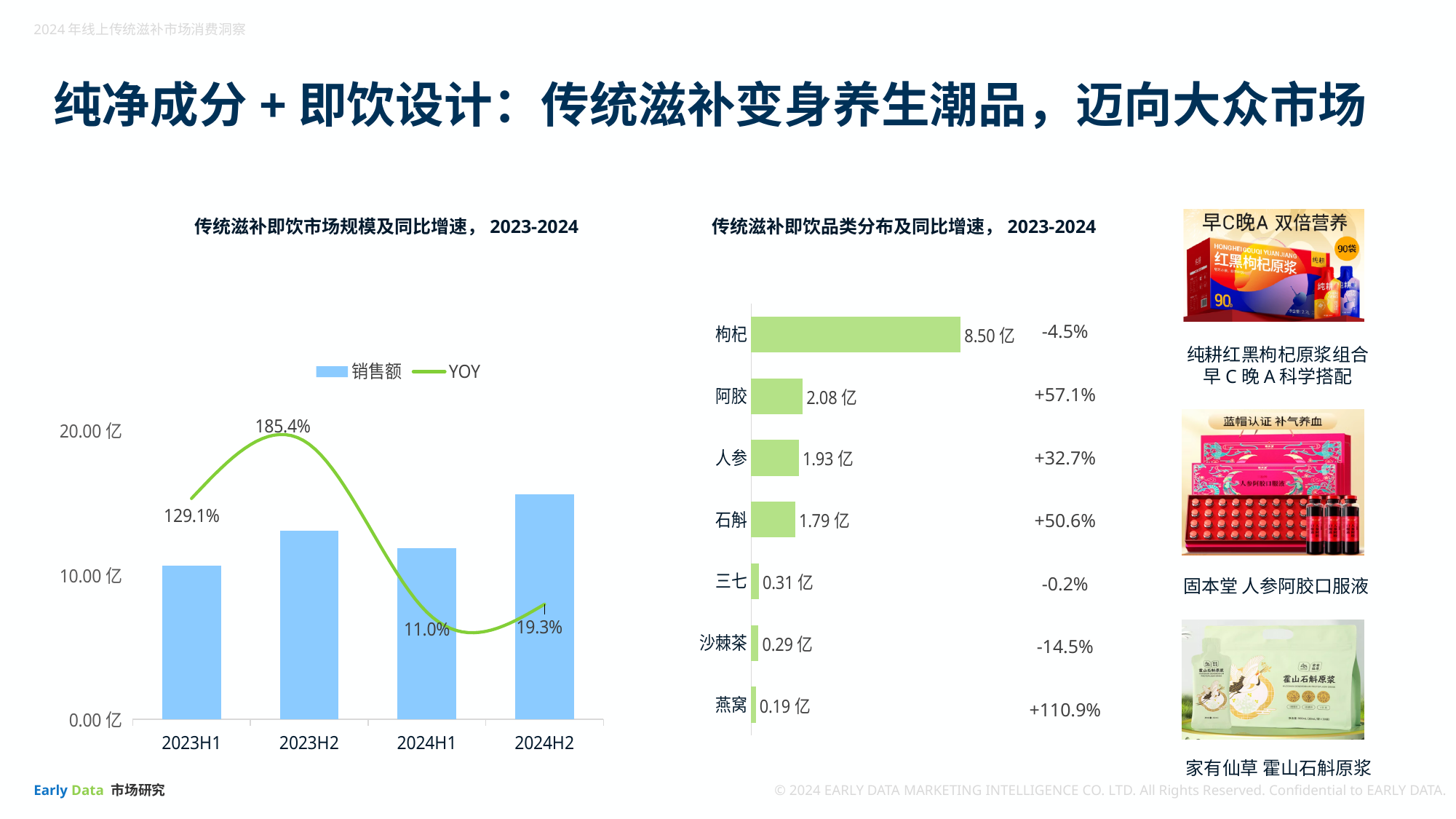
In the chart titled 传统滋补即饮品类分布及同比增速，2023-2024, what is the difference between the values for 枸杞 and 阿胶? 6.42 亿 In the chart titled 传统滋补即饮市场规模及同比增速，2023-2024, is the 销售额 bar for 2024H2 greater or less than 20.00 亿? less In the chart titled 传统滋补即饮市场规模及同比增速，2023-2024, is the 销售额 bar for 2023H2 greater or less than 10.00 亿? greater In the chart titled 传统滋补即饮市场规模及同比增速，2023-2024, which period has the highest YOY value? 2023H2 In the chart titled 传统滋补即饮市场规模及同比增速，2023-2024, how many series does the legend list? 2 In the chart titled 传统滋补即饮市场规模及同比增速，2023-2024, what is the YOY value for 2024H1? 11.0% In the chart titled 传统滋补即饮品类分布及同比增速，2023-2024, which category has the largest value? 枸杞 In the chart titled 传统滋补即饮品类分布及同比增速，2023-2024, what is the value for 阿胶? 2.08 亿 In the chart titled 传统滋补即饮市场规模及同比增速，2023-2024, what is the YOY value for 2023H2? 185.4% In the chart titled 传统滋补即饮品类分布及同比增速，2023-2024, what is the growth rate shown for 燕窝? +110.9% In the chart titled 传统滋补即饮品类分布及同比增速，2023-2024, how many categories are shown? 7 In the chart titled 传统滋补即饮品类分布及同比增速，2023-2024, which category has the smallest value? 燕窝